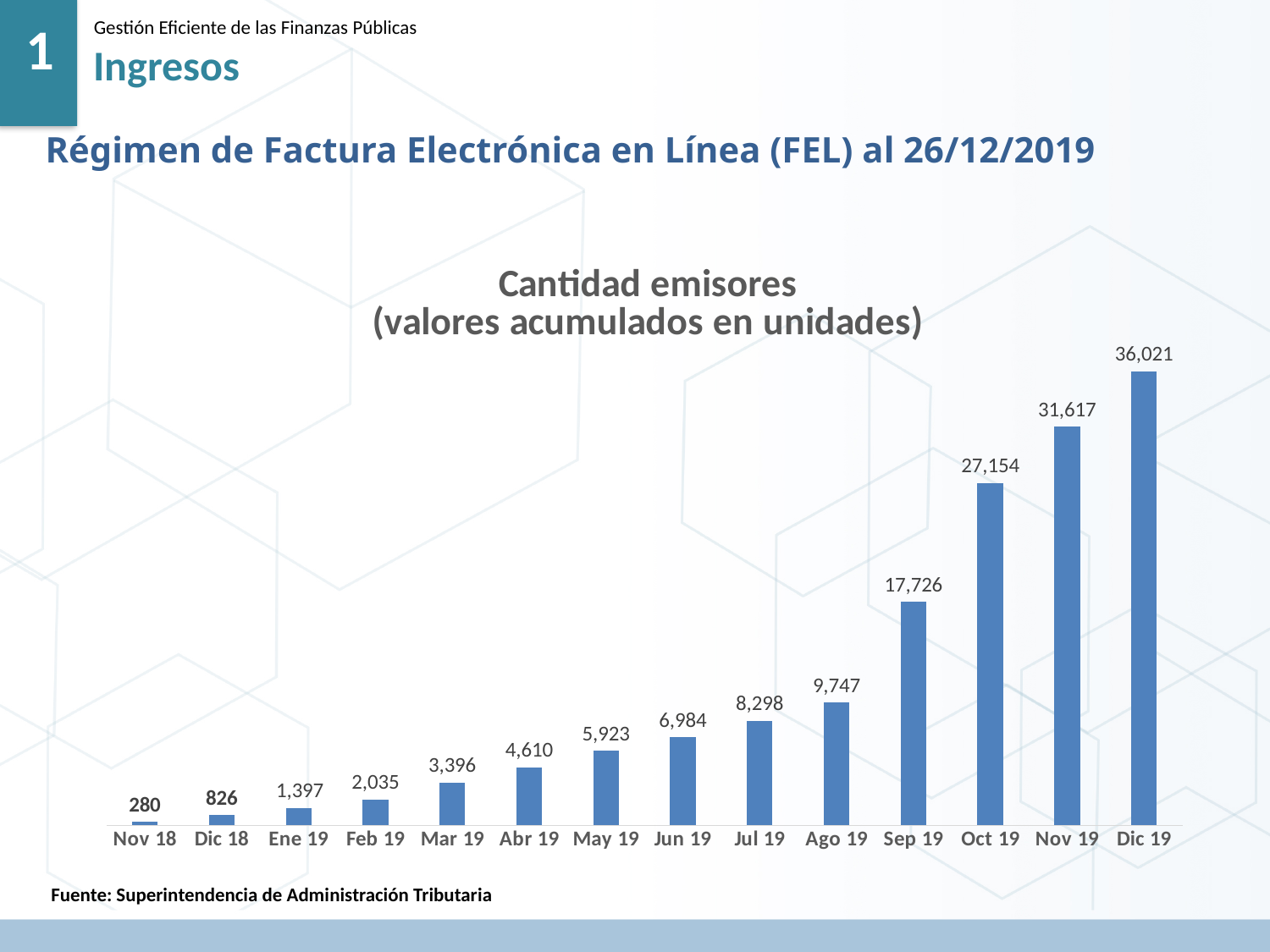
What is the title of the chart? Cantidad emisores (valores acumulados en unidades) Which month has the highest value? Dic 19 What is the value for Mar 19? 3,396 What is the value for Dic 19? 36,021 Which month has the lowest value? Nov 18 What is the difference between the values for Oct 19 and Sep 19? 9,428 What is the value for Sep 19? 17,726 Which is larger, the value for Jul 19 or the value for Ago 19? Ago 19 Do the values rise or fall from Nov 18 to Dic 19? Rise What kind of chart is this? Bar chart How many months are shown on the x axis? 14 What is the difference between the values for Dic 19 and Nov 19? 4,404